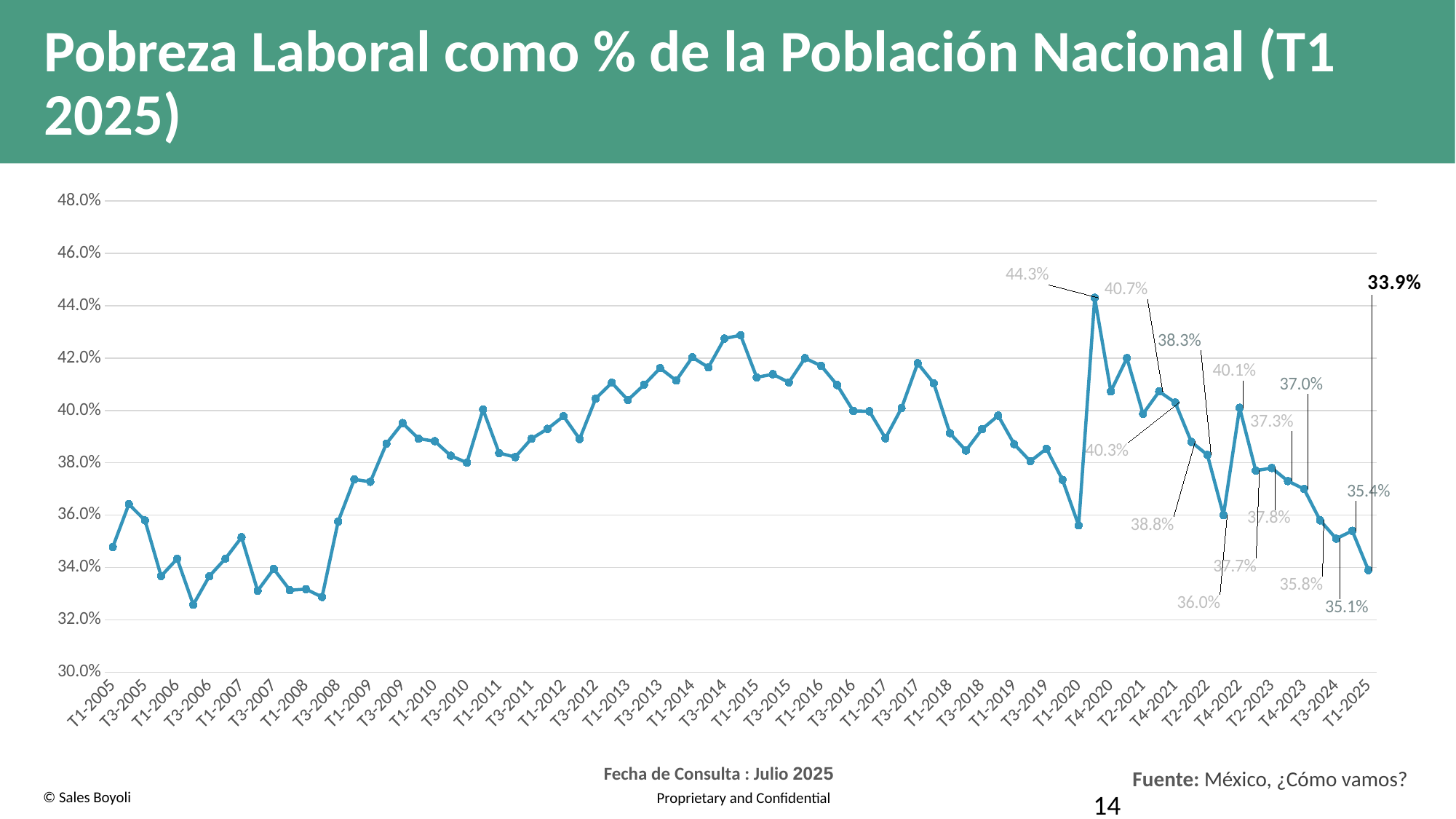
Is the value for T1-2009 greater or less than 38.0%? less Does the line generally rise or fall from T1-2008 to T3-2014? Rises Which is larger, the value for T3-2014 or the value for T1-2025? T3-2014 What is the difference between the 2020 peak of 44.3% and the T1-2025 value of 33.9%? 10.4 percentage points Does the line rise or fall from the 2020 peak to T1-2025? Falls What is the highest value shown on the chart (the spike in 2020)? 44.3% What is the value for T1-2025, the last point on the chart? 33.9% Is the value for T1-2014 greater or less than 40.0%? greater What is the title of the chart on the slide? Pobreza Laboral como % de la Población Nacional (T1 2025) What kind of chart is shown on the slide? Line chart What is the difference between the labeled value 35.4% and the final value 33.9%? 1.5 percentage points Is the value for T1-2020 greater or less than 38.0%? less